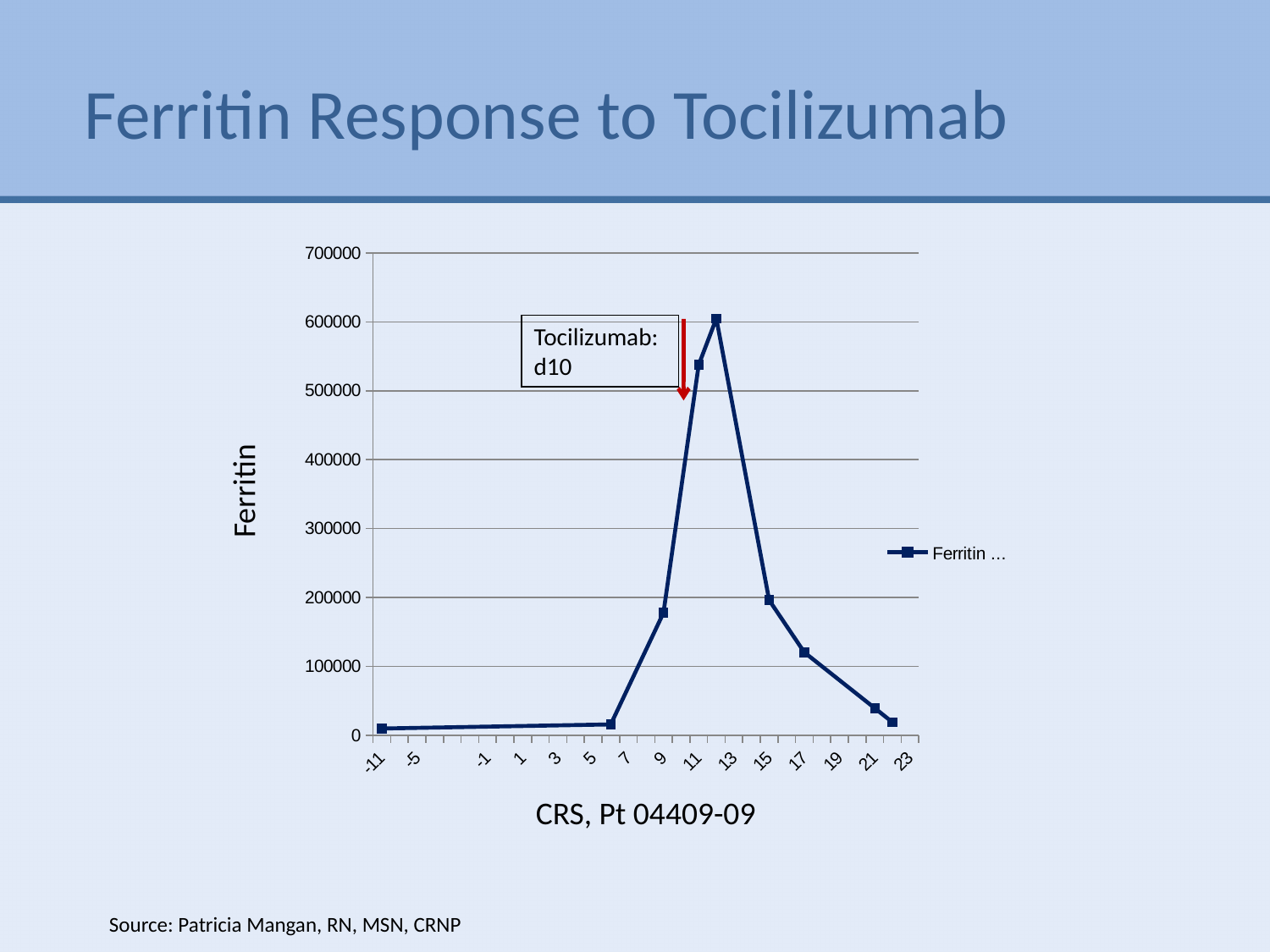
Is the ferritin value at day 9 greater or less than 200000? less Which is larger, the ferritin value at day 17 or at day 21? day 17 What is the title of the chart's x axis? CRS, Pt 04409-09 How many data points are plotted on the Ferritin line? 9 After the peak, do ferritin values rise or fall as the days increase? fall How many series does the legend list? 1 What kind of chart is shown on the slide? line chart Which is larger, the ferritin value at day 11 or at day 15? day 11 Is the ferritin value at day 17 greater or less than 100000? greater Is the ferritin value at day 11 greater or less than 500000? greater What is the title of the chart's y axis? Ferritin